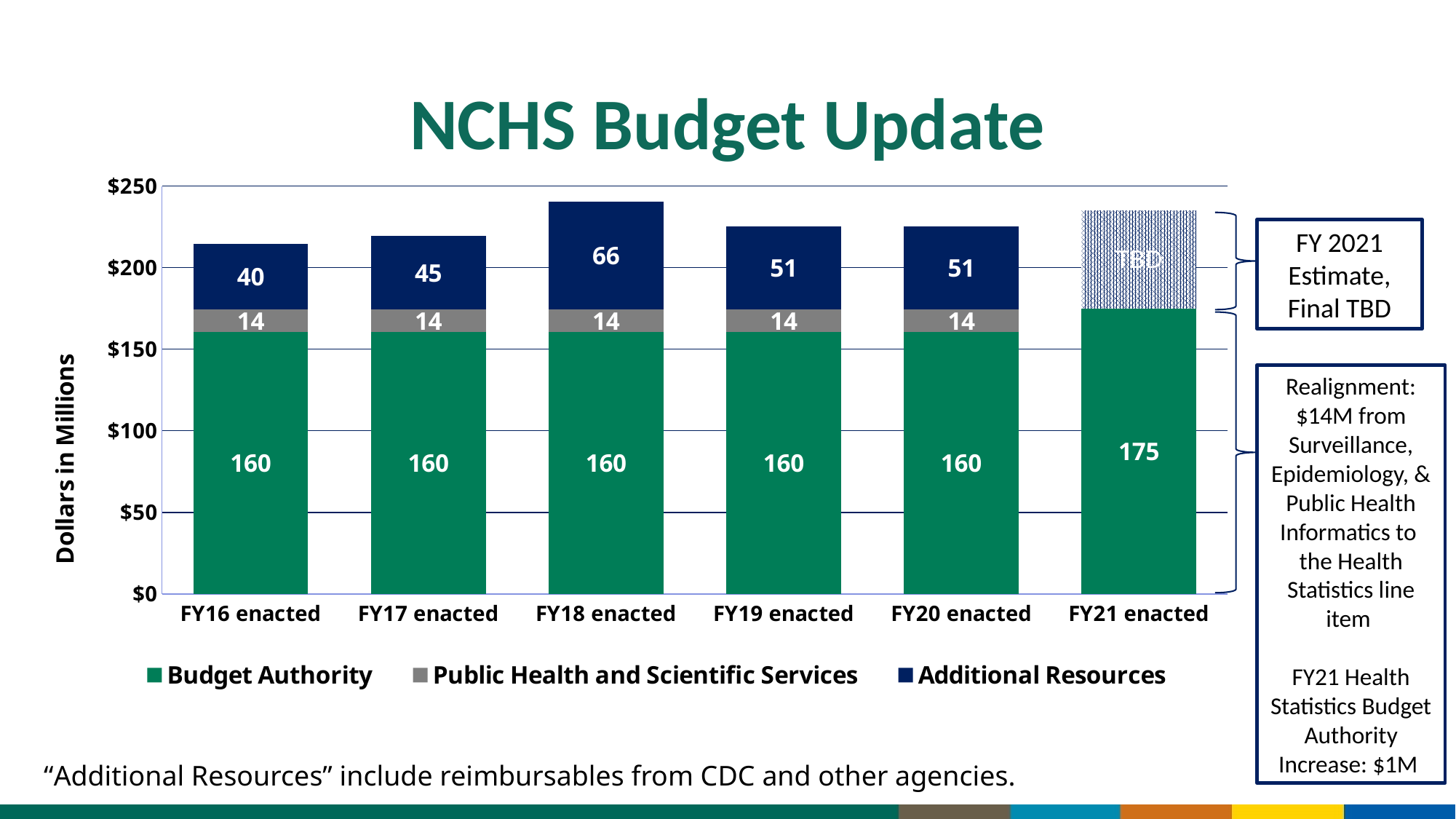
How many series does the legend list? 3 Which fiscal year has the lowest Additional Resources value? FY16 enacted What is the difference between the Additional Resources values for FY18 enacted and FY16 enacted? 26 What is the total of the stacked bar for FY18 enacted? 240 How many fiscal year categories are shown on the x axis? 6 What type of chart is shown on the slide? Stacked bar chart What is the Public Health and Scientific Services value for FY19 enacted? 14 What is the total of the stacked bar for FY16 enacted? 214 What is the Additional Resources value for FY18 enacted? 66 What is the Budget Authority value for FY21 enacted? 175 Is the Additional Resources value larger for FY17 enacted or FY19 enacted? FY19 enacted Which fiscal year has the highest Additional Resources value among the labeled values? FY18 enacted